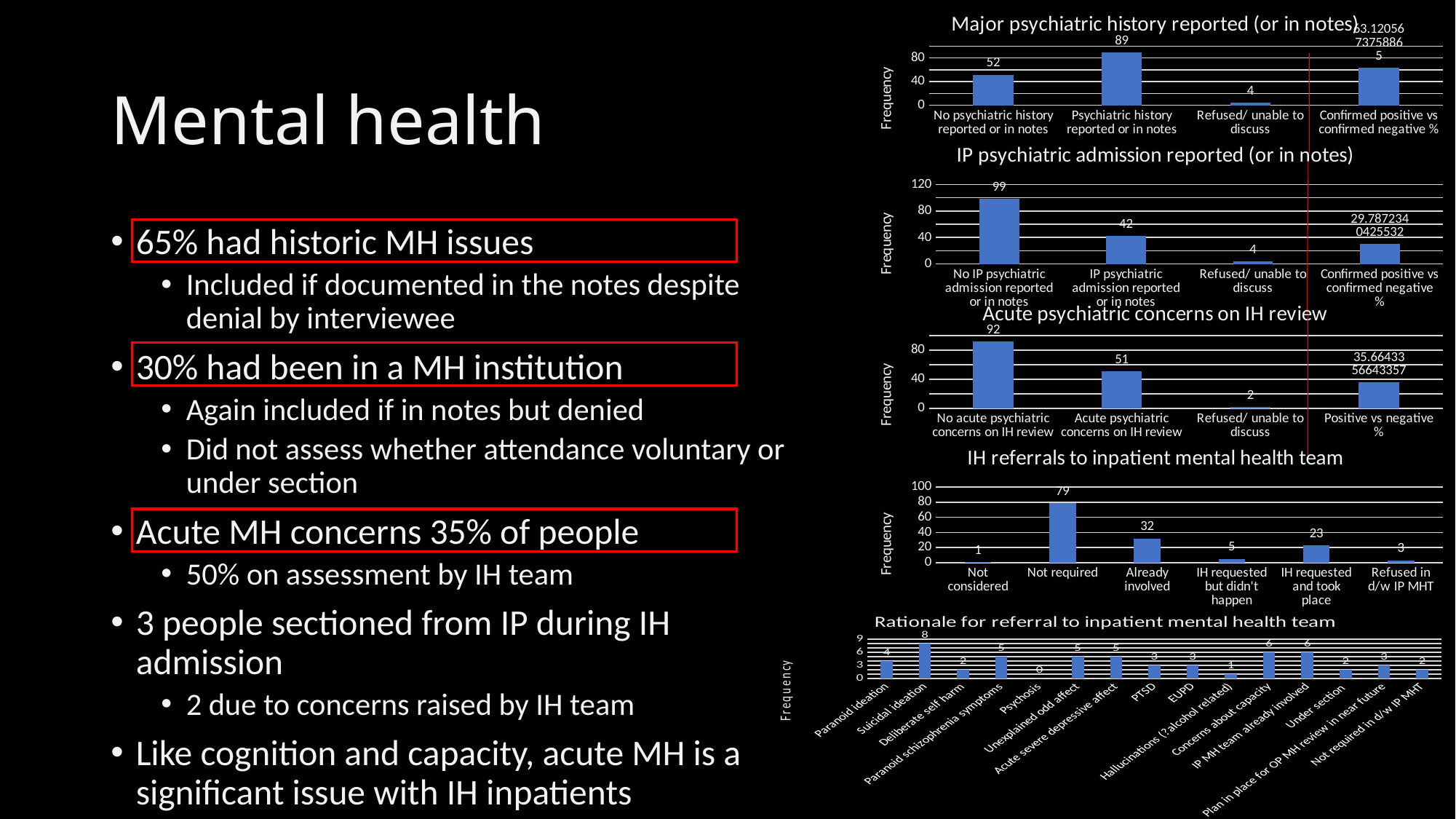
In the 'IH referrals to inpatient mental health team' chart, what is the difference between 'Not required' and 'Already involved'? 47 In the 'Rationale for referral to inpatient mental health team' chart, what is the value for 'Psychosis'? 0 In the 'Rationale for referral to inpatient mental health team' chart, which category has the highest value? Suicidal ideation In the 'IH referrals to inpatient mental health team' chart, which category has the lowest value? Not considered In the 'Acute psychiatric concerns on IH review' chart, which is larger: 'No acute psychiatric concerns on IH review' or 'Acute psychiatric concerns on IH review'? No acute psychiatric concerns on IH review How many categories are shown in the 'IH referrals to inpatient mental health team' chart? 6 In the 'IH referrals to inpatient mental health team' chart, what is the value for 'IH requested and took place'? 23 What type of chart is 'Rationale for referral to inpatient mental health team'? Bar chart In the 'Acute psychiatric concerns on IH review' chart, what is the value for 'Refused/ unable to discuss'? 2 In the 'Major psychiatric history reported (or in notes)' chart, what is the value for 'Psychiatric history reported or in notes'? 89 In the 'IH referrals to inpatient mental health team' chart, what is the value for 'Not required'? 79 In the 'IP psychiatric admission reported (or in notes)' chart, what is the value for 'No IP psychiatric admission reported or in notes'? 99